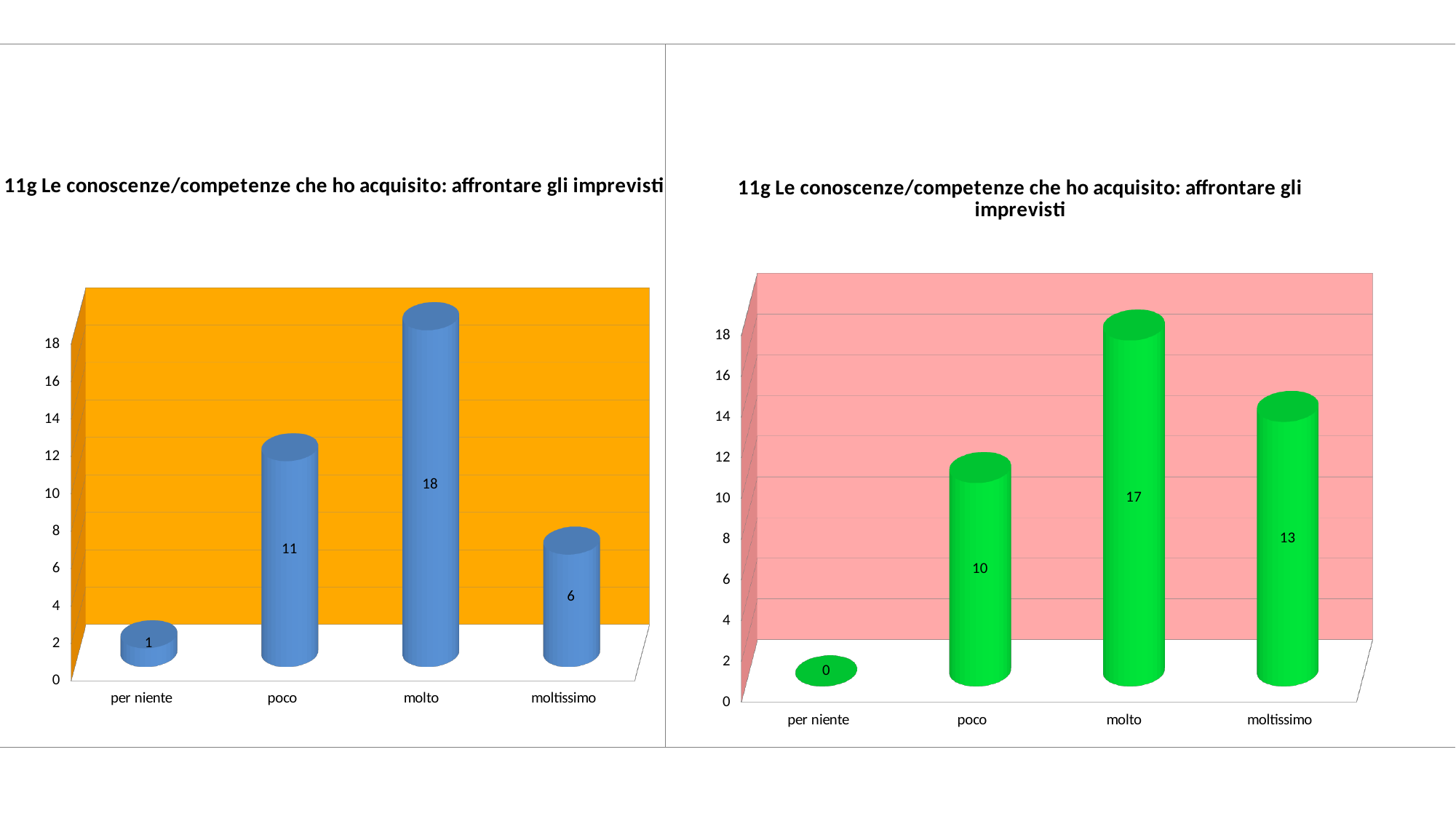
What colour are the bars in the left chart? blue In the right chart, what is the difference between the values for 'molto' and 'poco'? 7 In the left chart, which category has the highest value? molto In the right chart, what is the value for 'poco'? 10 What kind of chart is the right chart? bar chart In the right chart, what is the value for 'moltissimo'? 13 In the left chart, what is the difference between the values for 'molto' and 'moltissimo'? 12 In the left chart, what is the value for 'molto'? 18 How many categories are shown on the x axis of the left chart? 4 In the left chart, what is the value for 'per niente'? 1 In the right chart, which is larger, the value for 'moltissimo' or the value for 'poco'? moltissimo In the right chart, which category has the lowest value? per niente